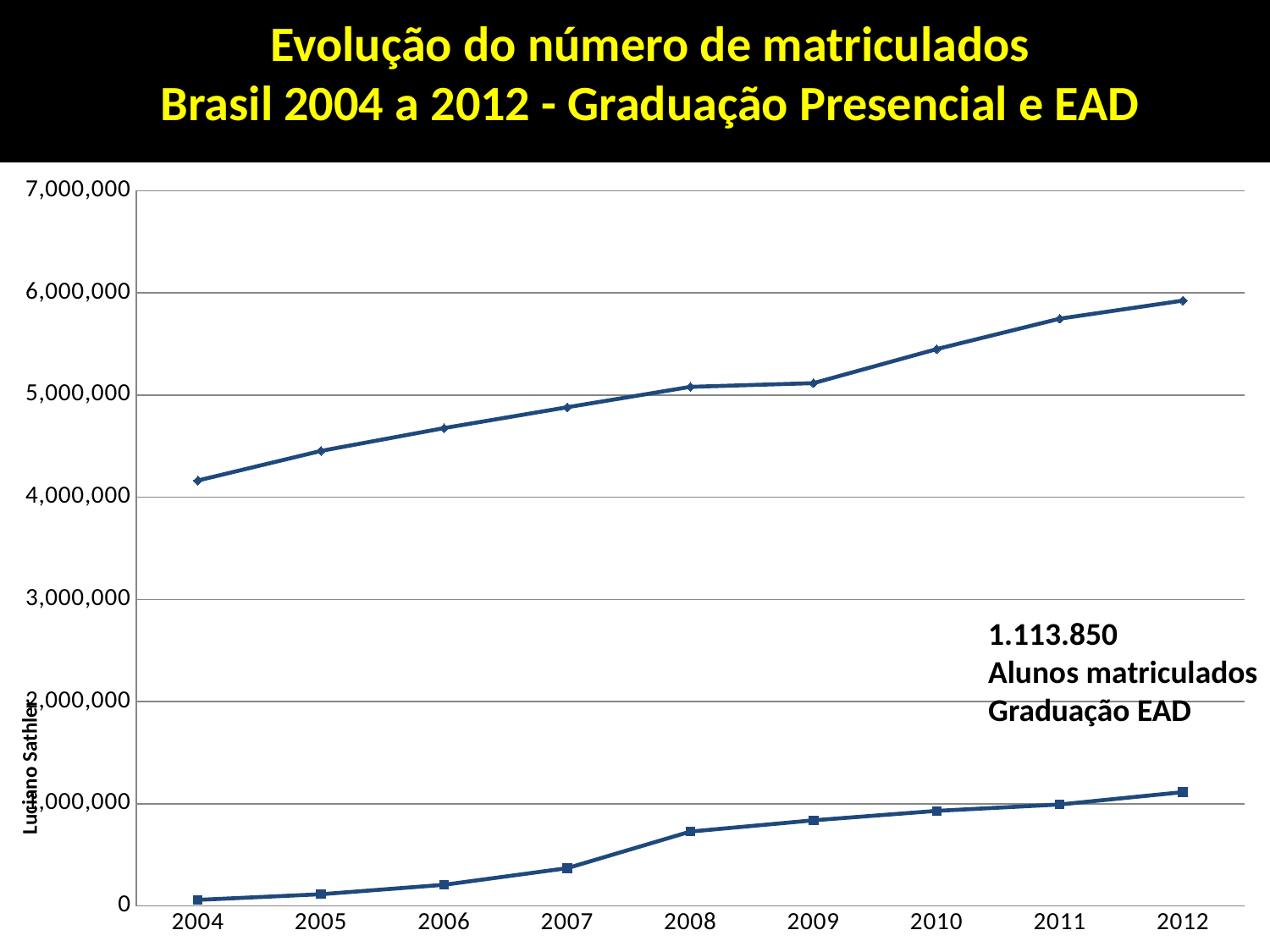
Is the value of the upper line in 2010 greater or less than 5,000,000? greater Is the value of the lower line in 2008 greater or less than 1,000,000? less Does the lower line (square markers) rise or fall from 2004 to 2012? rise In which year does the upper line reach its highest value? 2012 Is the value of the upper line in 2012 greater or less than 6,000,000? less What kind of chart is shown on the slide? line chart What number of students enrolled in Graduação EAD is printed on the slide? 1.113.850 What is the highest tick value shown on the y axis? 7,000,000 Does the upper line (diamond markers) rise or fall from 2004 to 2012? rise In which year does the lower line have its lowest value? 2004 How many years are plotted along the x axis? 9